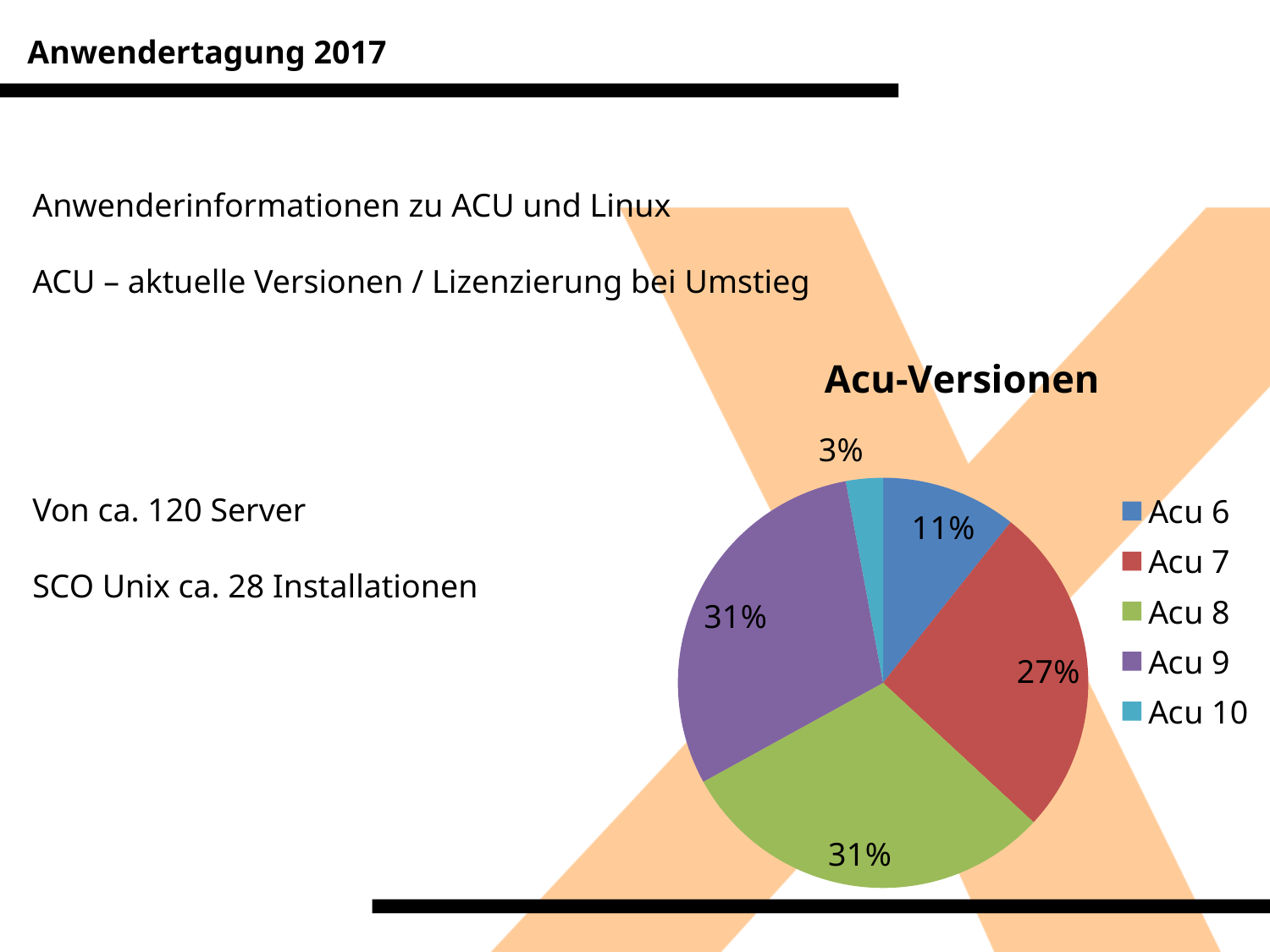
What kind of chart is shown on the slide? Pie chart What share of the pie does Acu 6 have? 11% What is the difference in percentage points between the Acu 8 slice and the Acu 7 slice? 4 What is the difference in percentage points between the Acu 6 slice and the Acu 10 slice? 8 How many slices does the pie chart have? 5 What share of the pie does Acu 9 have? 31% What share of the pie does Acu 10 have? 3% What is the title of the chart? Acu-Versionen Which version has the smallest slice of the pie? Acu 10 What share of the pie does Acu 8 have? 31% What share of the pie does Acu 7 have? 27% Which is larger, the slice for Acu 7 or the slice for Acu 6? Acu 7